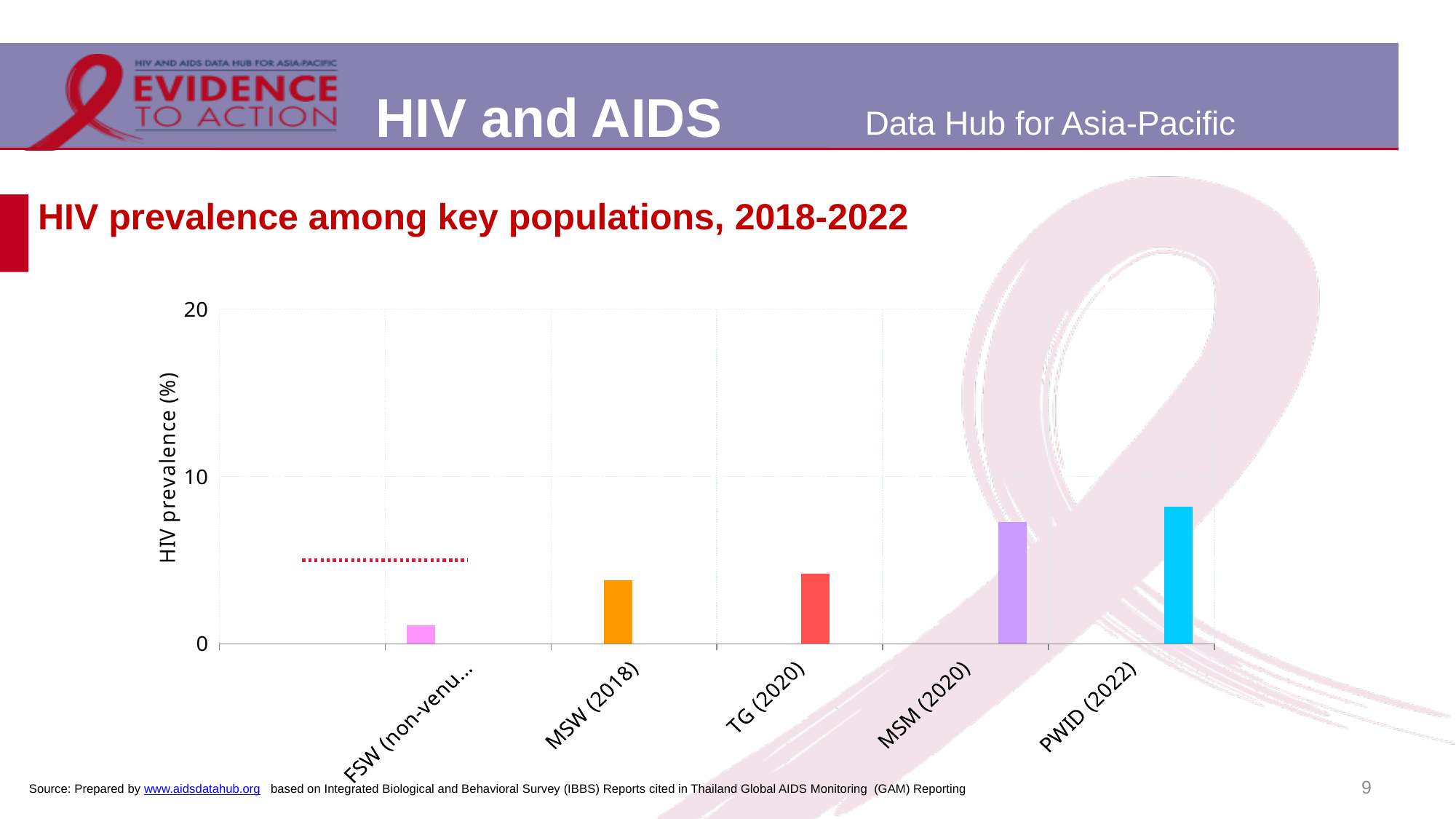
Which has a higher HIV prevalence, MSM (2020) or MSW (2018)? MSM (2020) Is the HIV prevalence for MSW (2018) greater or less than 10? less What is the title of the chart? HIV prevalence among key populations, 2018-2022 How many key population categories are plotted on the x axis? 5 Do the bar values generally rise or fall from left to right along the x axis? rise Which has a higher HIV prevalence, TG (2020) or FSW (non-venu...)? TG (2020) Which category has the lowest HIV prevalence? FSW (non-venu...) Which category has the highest HIV prevalence? PWID (2022) What is the label of the y axis? HIV prevalence (%) Is the HIV prevalence for PWID (2022) greater or less than 10? less What kind of chart is shown on the slide? bar chart Is the HIV prevalence for MSM (2020) greater or less than 10? less